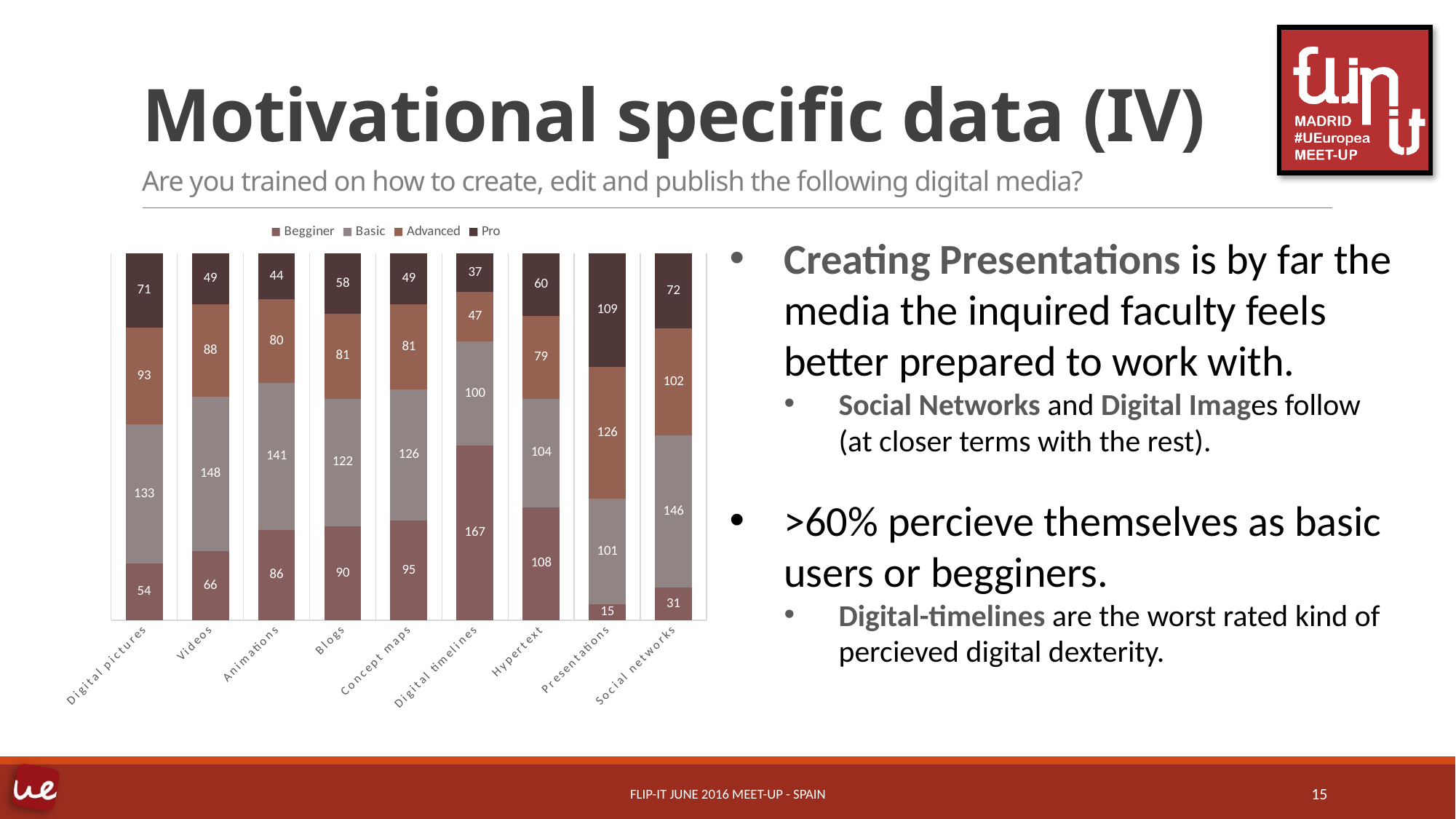
What is the Basic value for Social networks? 146 What kind of chart is shown on the slide? Stacked bar chart What is the total of the stacked bar for Presentations? 351 What is the Pro value for Presentations? 109 What is the Begginer value for Digital timelines? 167 What is the difference between the Basic values for Videos and Blogs? 26 Which is larger, the Pro value for Digital pictures or the Pro value for Hypertext? Digital pictures How many categories are shown on the x axis? 9 Which category has the highest Advanced value? Presentations Which legend entry is shown in the darkest colour? Pro Which category has the lowest Begginer value? Presentations How many series does the legend list? 4